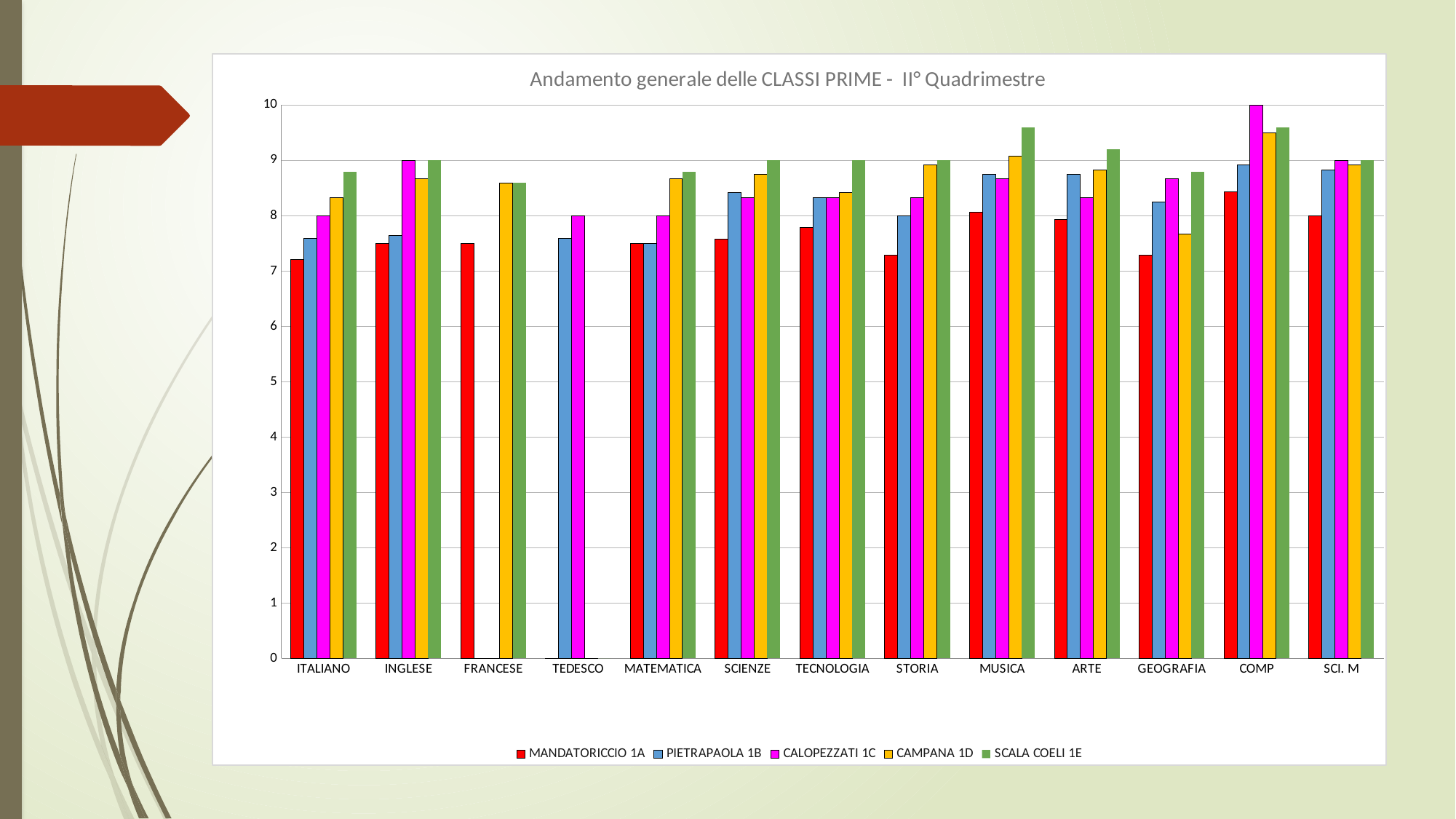
What is the value for CALOPEZZATI 1C in INGLESE? 9 Is the value for MANDATORICCIO 1A in ITALIANO greater or less than 8? less What is the title of the chart? Andamento generale delle CLASSI PRIME - II° Quadrimestre What is the value for CALOPEZZATI 1C in TEDESCO? 8 Which series has the highest bar in the COMP category? CALOPEZZATI 1C What kind of chart is shown on the slide? bar chart Is the value for SCALA COELI 1E in MUSICA greater or less than 9? greater How many series does the legend list? 5 What colour represents SCALA COELI 1E in the legend? green What is the value for CALOPEZZATI 1C in COMP? 10 How many subject categories are shown on the x axis? 13 In GEOGRAFIA, which is larger: CALOPEZZATI 1C or CAMPANA 1D? CALOPEZZATI 1C